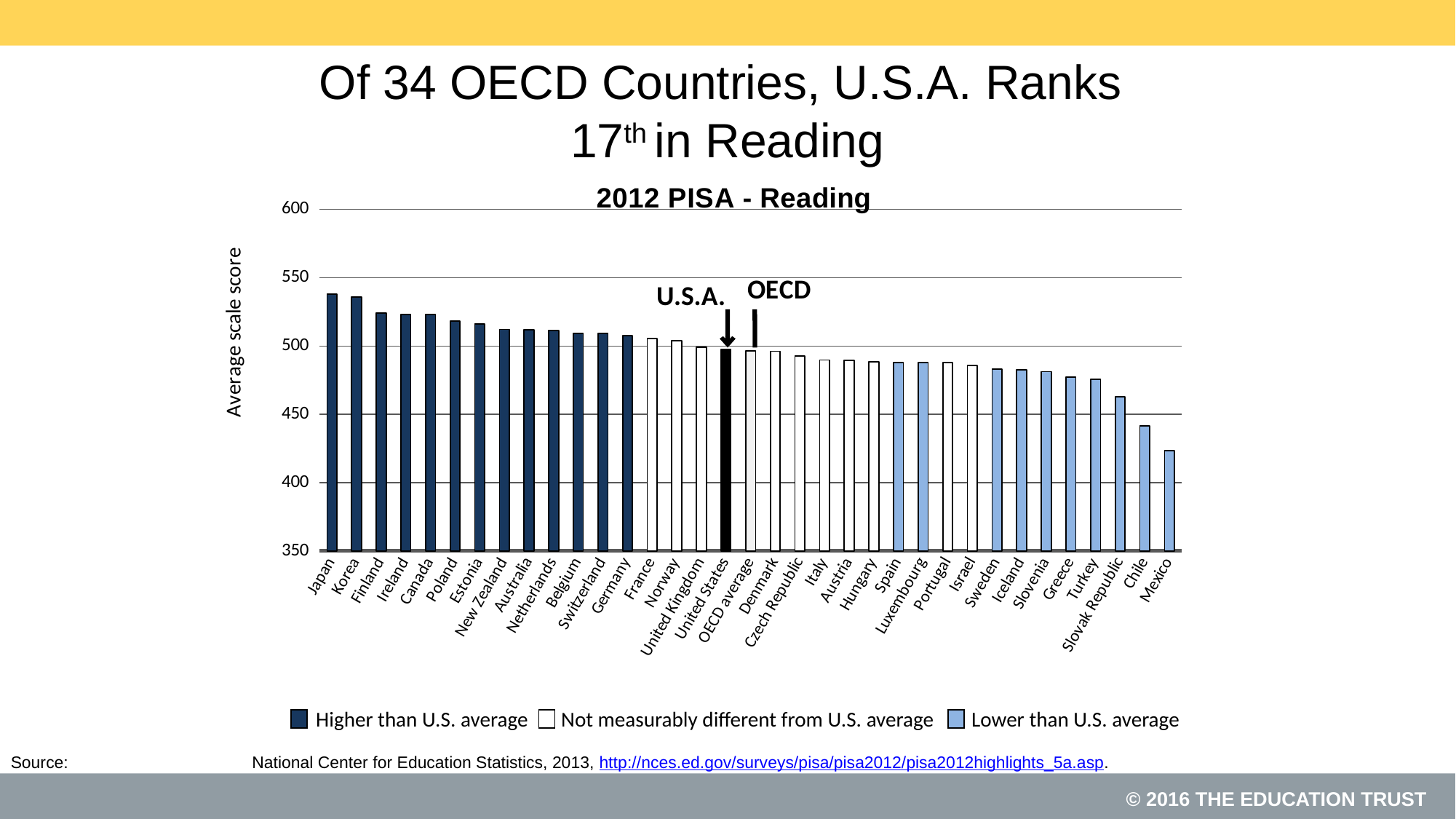
How many entries does the legend of the chart list? 3 Which country has the lowest average scale score in the 2012 PISA - Reading chart? Mexico Is the value for Mexico greater or less than 450? less Is the value for Japan greater or less than 500? greater Which has the larger average scale score, Korea or Germany? Korea What type of chart is shown on the slide? Bar chart Do the average scale scores rise or fall moving from left to right along the x axis? Fall How many bars are plotted in the 2012 PISA - Reading chart, including the OECD average? 35 Which country has the highest average scale score in the 2012 PISA - Reading chart? Japan Which has the larger average scale score, Turkey or Chile? Turkey Is the value for Slovak Republic greater or less than 500? less What is the title of the chart on the slide? 2012 PISA - Reading